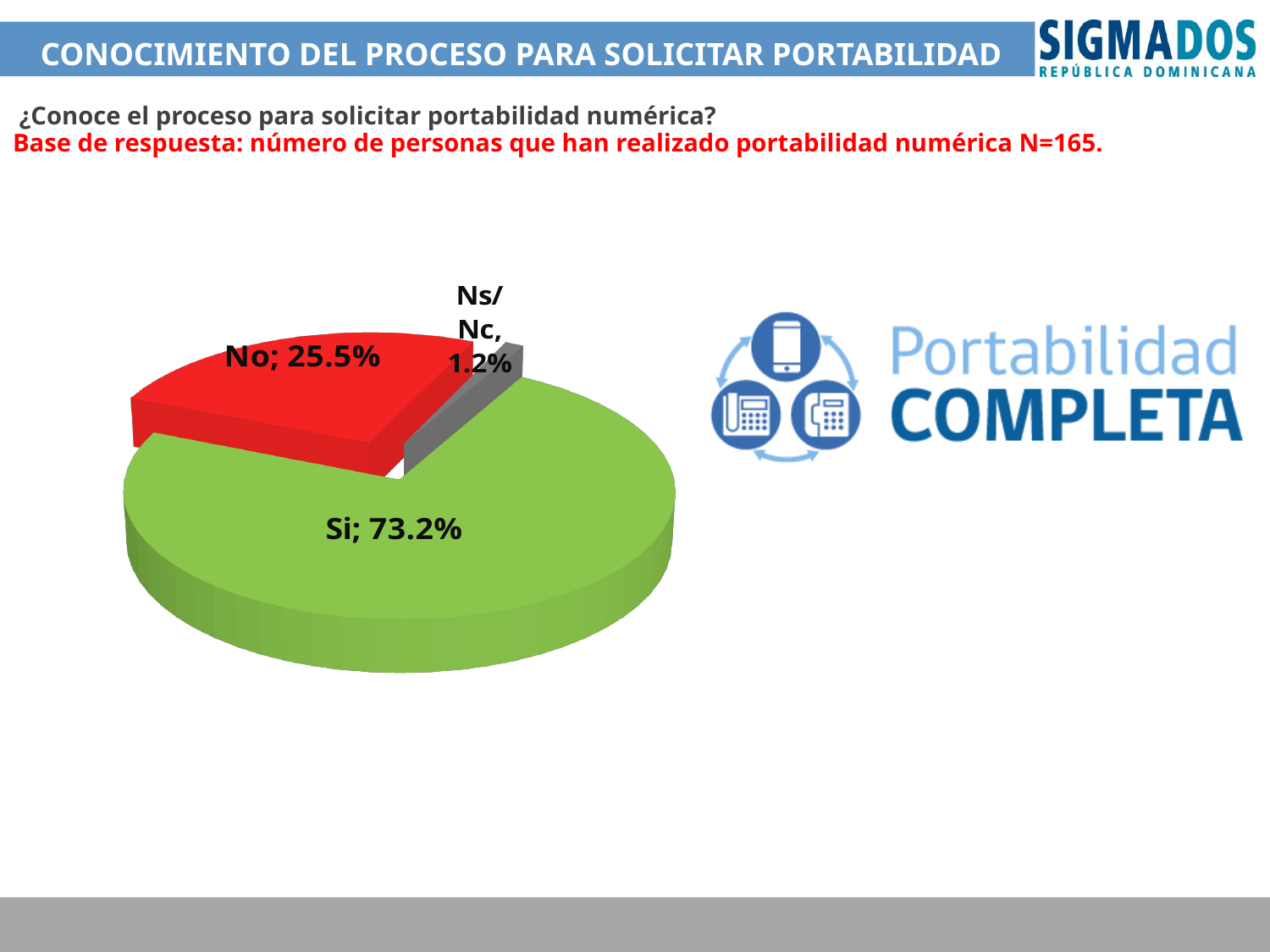
What percentage of respondents answered "No"? 25.5% Which response has the largest share of the pie? Si What is the difference in percentage points between "No" and "Ns/Nc"? 24.3 What percentage of respondents answered "Si"? 73.2% Which is larger, the share for "No" or the share for "Ns/Nc"? No What is the difference in percentage points between "Si" and "No"? 47.7 What percentage of respondents answered "Ns/Nc"? 1.2% What kind of chart is shown on the slide? pie chart What colour is the "No" slice of the pie chart? red How many slices does the pie chart have? 3 Which response has the smallest share of the pie? Ns/Nc What colour is the "Si" slice of the pie chart? green